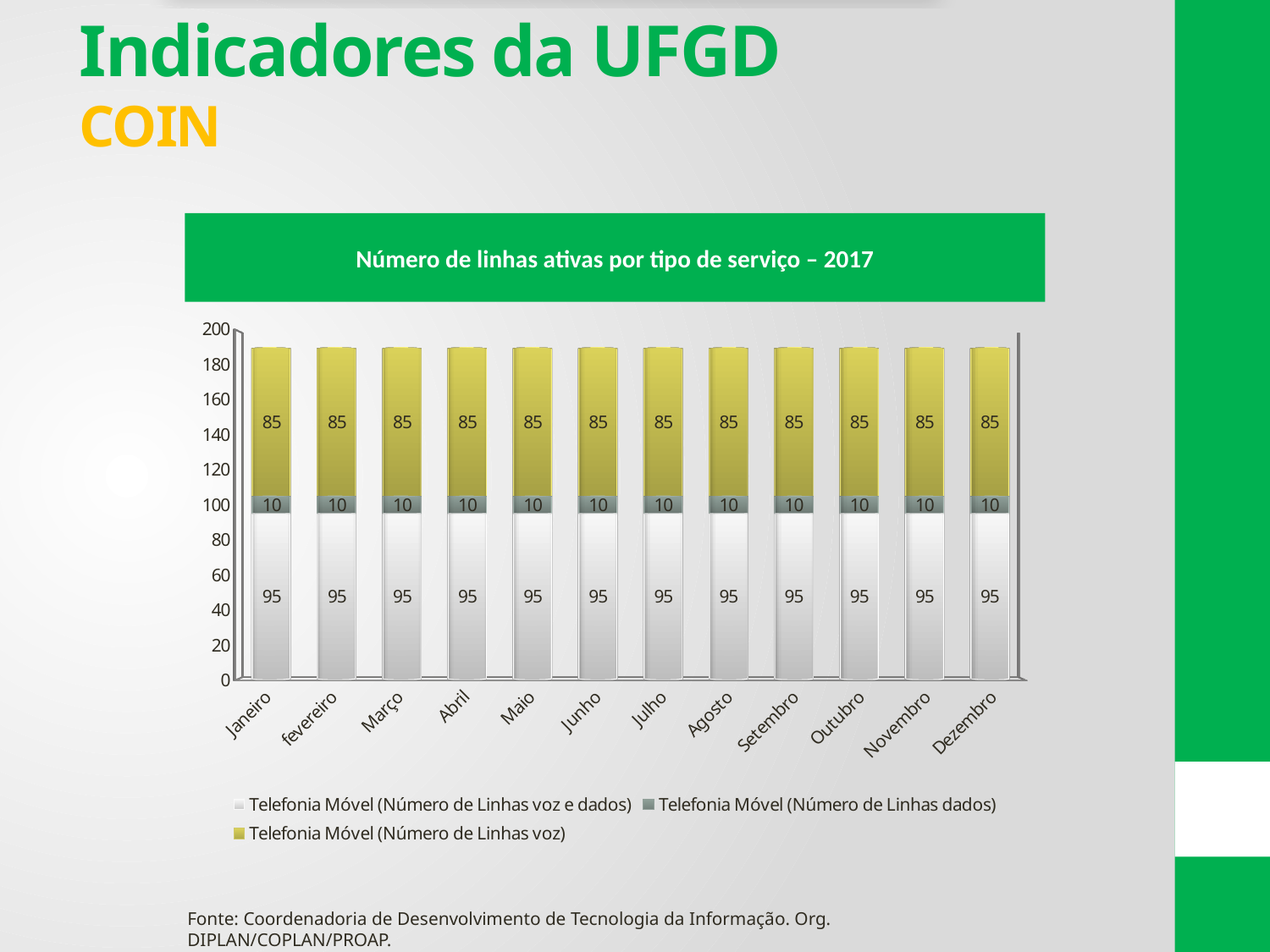
In Setembro, which is larger: Número de Linhas voz e dados or Número de Linhas dados? Número de Linhas voz e dados What is the difference between the Número de Linhas voz e dados value and the Número de Linhas voz value in Maio? 10 What is the value for Telefonia Móvel (Número de Linhas dados) in Julho? 10 How many months are shown on the x axis? 12 What is the value for Telefonia Móvel (Número de Linhas voz e dados) in Janeiro? 95 What is the total of the stacked bar for Março? 190 What kind of chart is shown on the slide? Stacked bar chart Which series is shown in yellow in the chart? Telefonia Móvel (Número de Linhas voz) What is the value for Telefonia Móvel (Número de Linhas voz) in Dezembro? 85 Do the total values of the stacked bars rise, fall or stay the same from Janeiro to Dezembro? Stay the same How many series does the legend list? 3 What is the chart's title? Número de linhas ativas por tipo de serviço – 2017